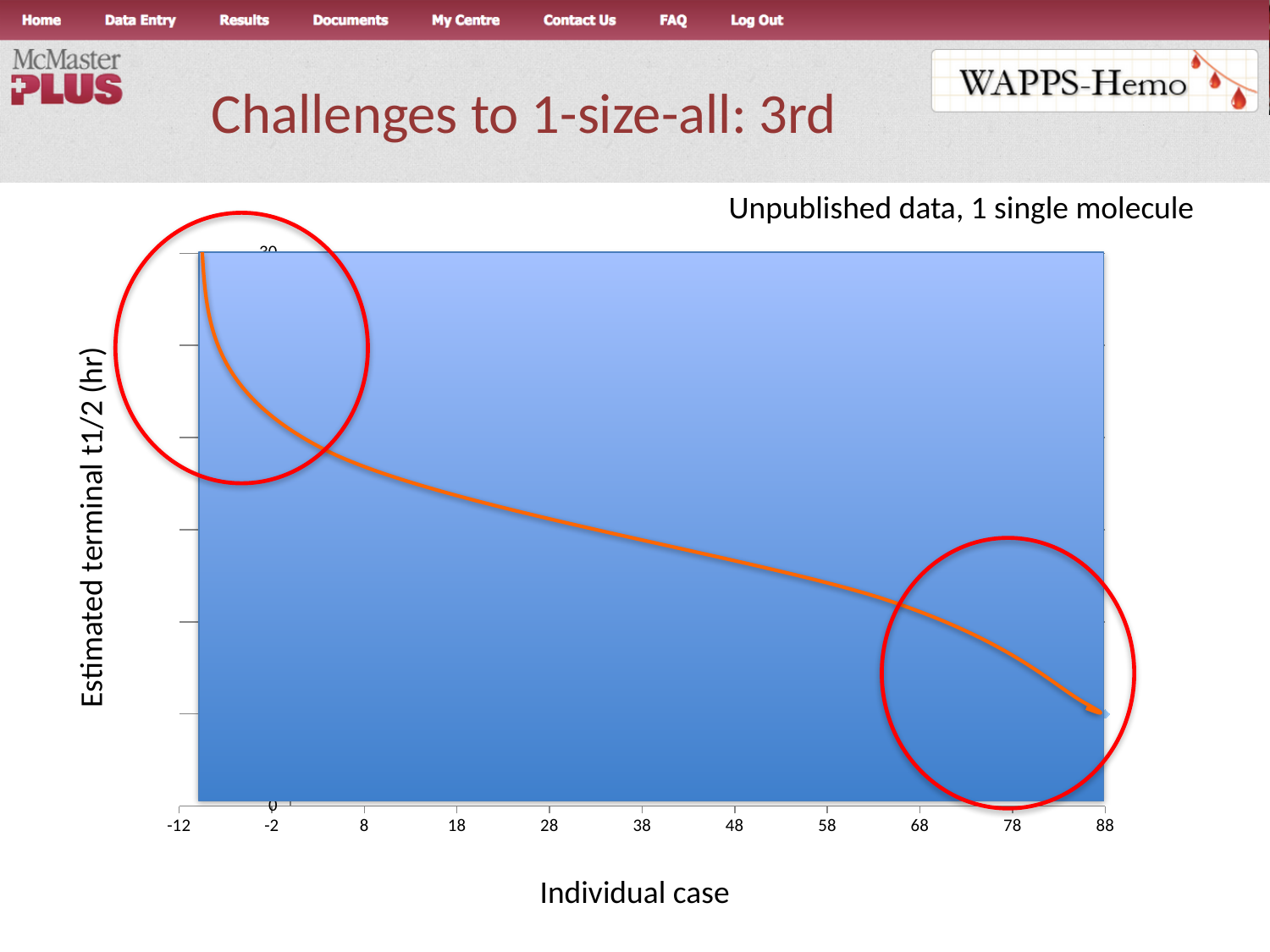
What is the label of the x axis of the chart? Individual case Is the estimated terminal t1/2 higher at individual case 28 or at individual case 58? 28 Is the estimated terminal t1/2 at individual case 88 greater or less than 30? less Is the estimated terminal t1/2 at individual case 48 greater or less than 0? greater What is the highest value labelled on the x axis of the chart? 88 Is the estimated terminal t1/2 higher at individual case 8 or at individual case 78? 8 What is the label of the y axis of the chart? Estimated terminal t1/2 (hr) Do the values of estimated terminal t1/2 rise or fall as the individual case number increases along the x axis? fall What kind of chart is shown on the slide? line chart